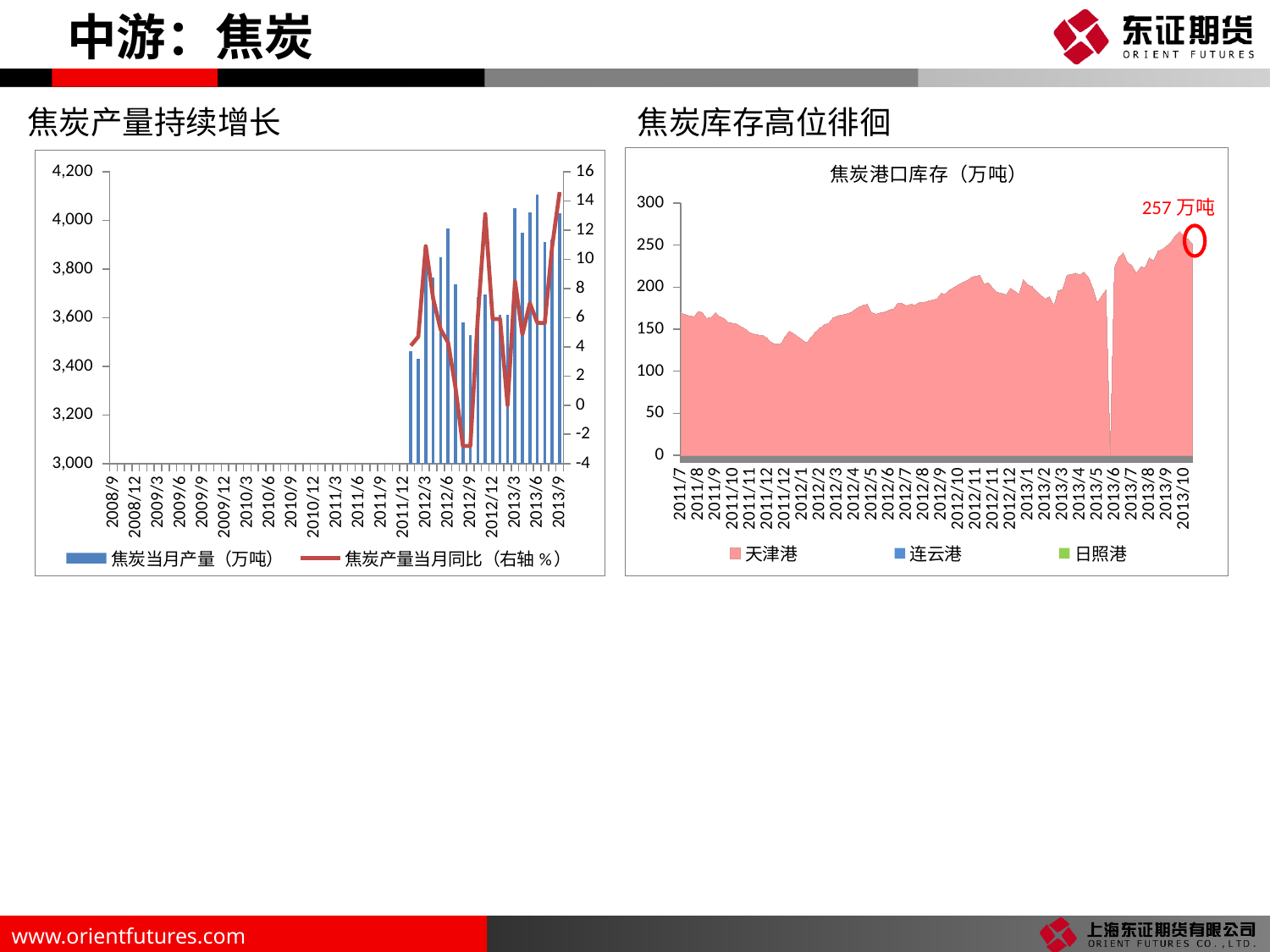
In the left chart (焦炭产量持续增长), is the 焦炭产量当月同比 line value around 2012/9 greater or less than 0? less How many series does the legend of the right chart (焦炭港口库存) list? 3 How many series does the legend of the left chart (焦炭产量持续增长) list? 2 In the left chart (焦炭产量持续增长), is the 焦炭产量当月同比 line value at 2013/9 greater or less than 12? greater What is the title of the chart on the right? 焦炭港口库存（万吨） In the right chart (焦炭港口库存), is the inventory value at 2011/7 greater or less than 150? greater In the right chart (焦炭港口库存), what value is annotated at the latest point, 2013/10? 257 万吨 What are the two legend entries of the left chart (焦炭产量持续增长)? 焦炭当月产量（万吨）and 焦炭产量当月同比（右轴 %） In the right chart (焦炭港口库存), do the inventory values overall rise or fall from 2011/7 to 2013/10? rise What kind of chart is the right chart (焦炭港口库存)? Area chart